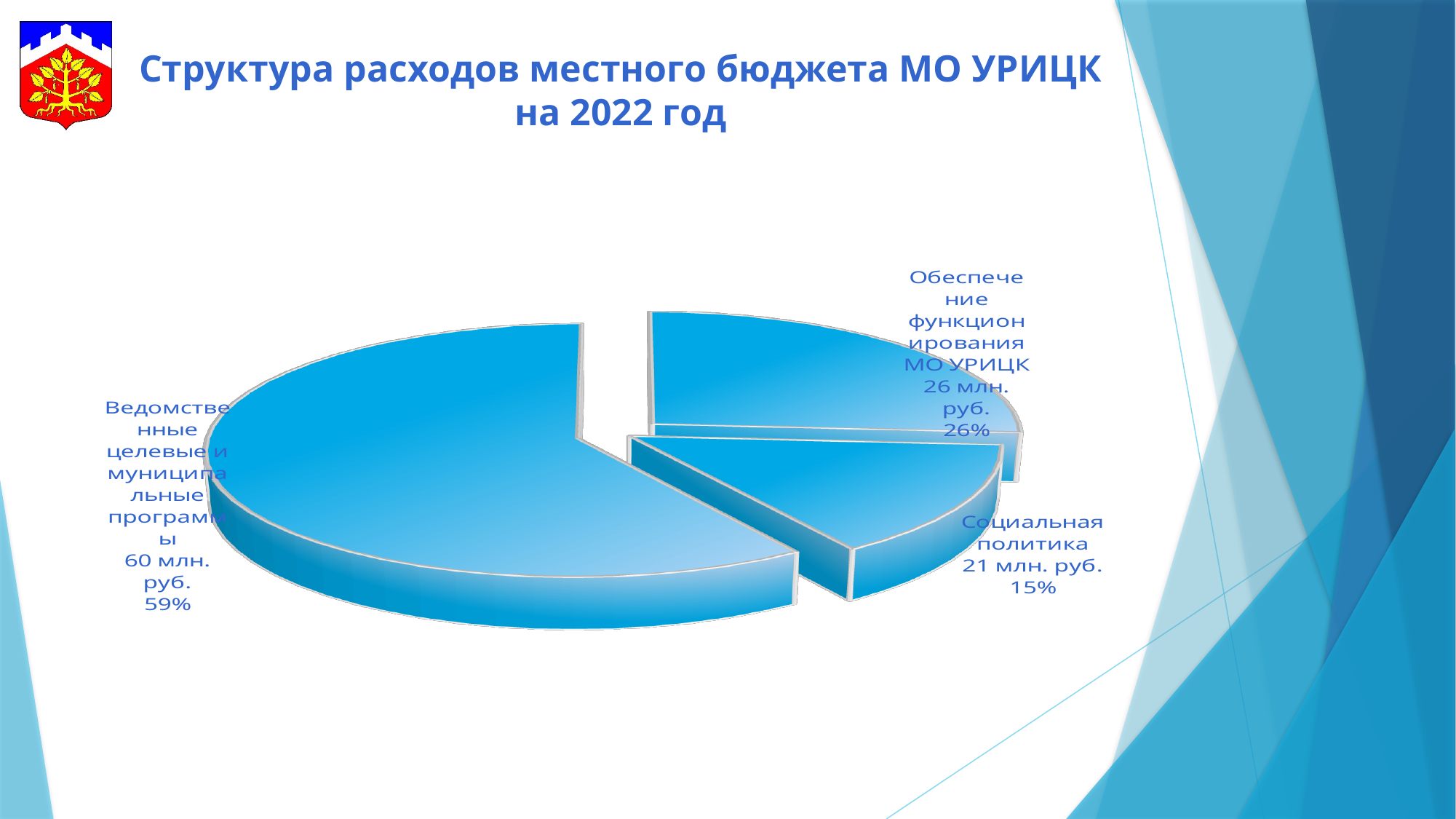
Which category has the smallest slice? Социальная политика What is the title of the slide? Структура расходов местного бюджета МО УРИЦК на 2022 год What share of the pie does Ведомственные целевые и муниципальные программы represent? 59% Which category has the largest slice? Ведомственные целевые и муниципальные программы Which is larger, Обеспечение функционирования МО УРИЦК or Социальная политика? Обеспечение функционирования МО УРИЦК What is the value for Социальная политика? 21 млн. руб. What kind of chart is shown on the slide? pie chart What is the difference between Ведомственные целевые и муниципальные программы and Обеспечение функционирования МО УРИЦК? 34 млн. руб. What is the value for Обеспечение функционирования МО УРИЦК? 26 млн. руб. How many slices does the pie chart have? 3 What is the value for Ведомственные целевые и муниципальные программы? 60 млн. руб. What share of the pie does Социальная политика represent? 15%